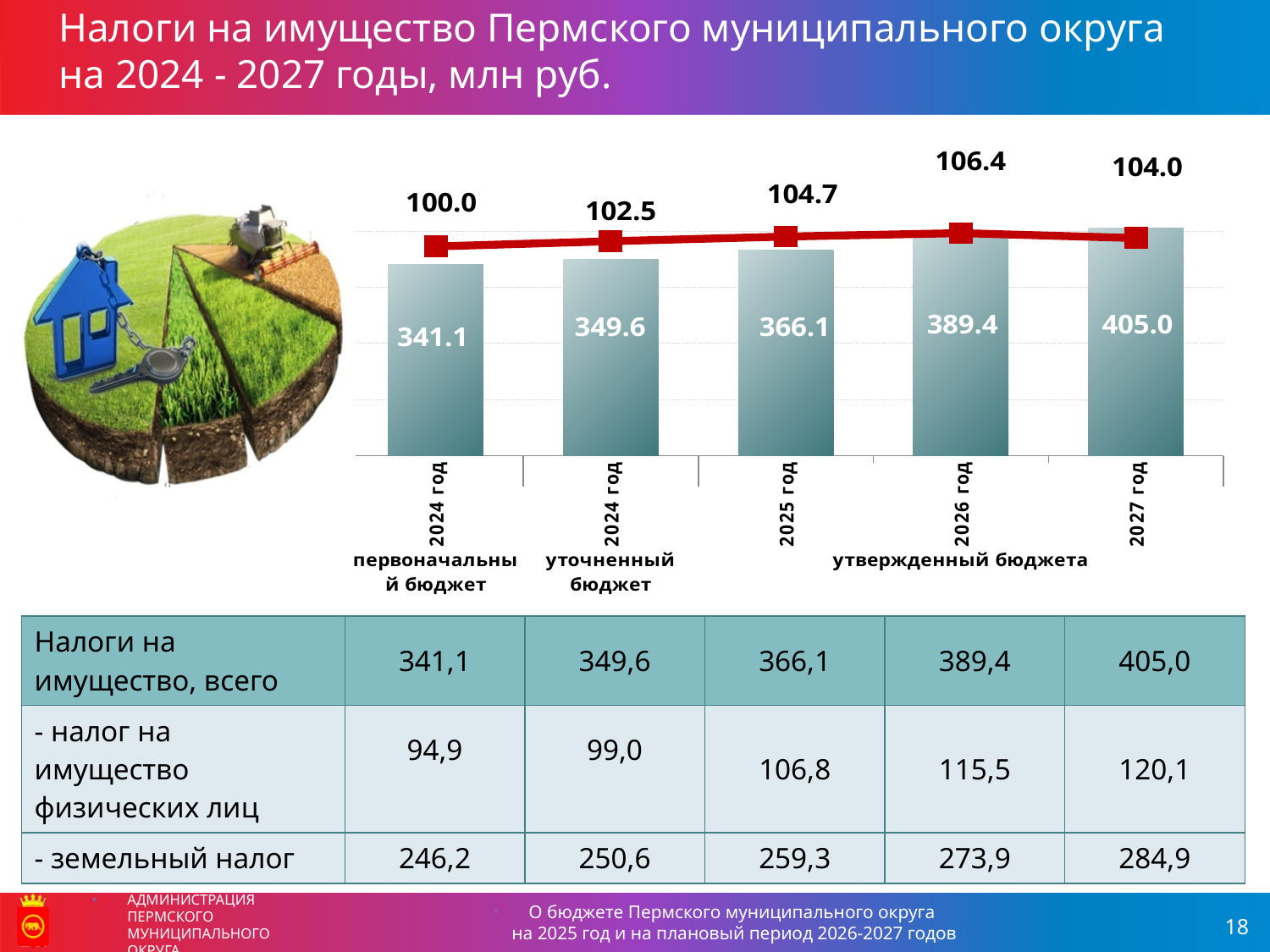
What is the bar value for 2025 год? 366.1 Do the bar values rise or fall from left to right along the x axis? rise Which is larger, the bar value for 2025 год or for 2026 год? 2026 год What is the line value shown above the bar for 2026 год? 106.4 Which category has the highest bar value? 2027 год What is the difference between the bar values for 2024 год уточненный бюджет and 2024 год первоначальный бюджет? 8.5 What is the line value shown above the bar for 2027 год? 104.0 Which category has the lowest bar value? 2024 год (первоначальный бюджет) How many categories are shown on the x axis of the chart? 5 What is the difference between the bar values for 2027 год and 2026 год? 15.6 Which category has the highest line value? 2026 год What is the bar value for 2024 год (первоначальный бюджет)? 341.1